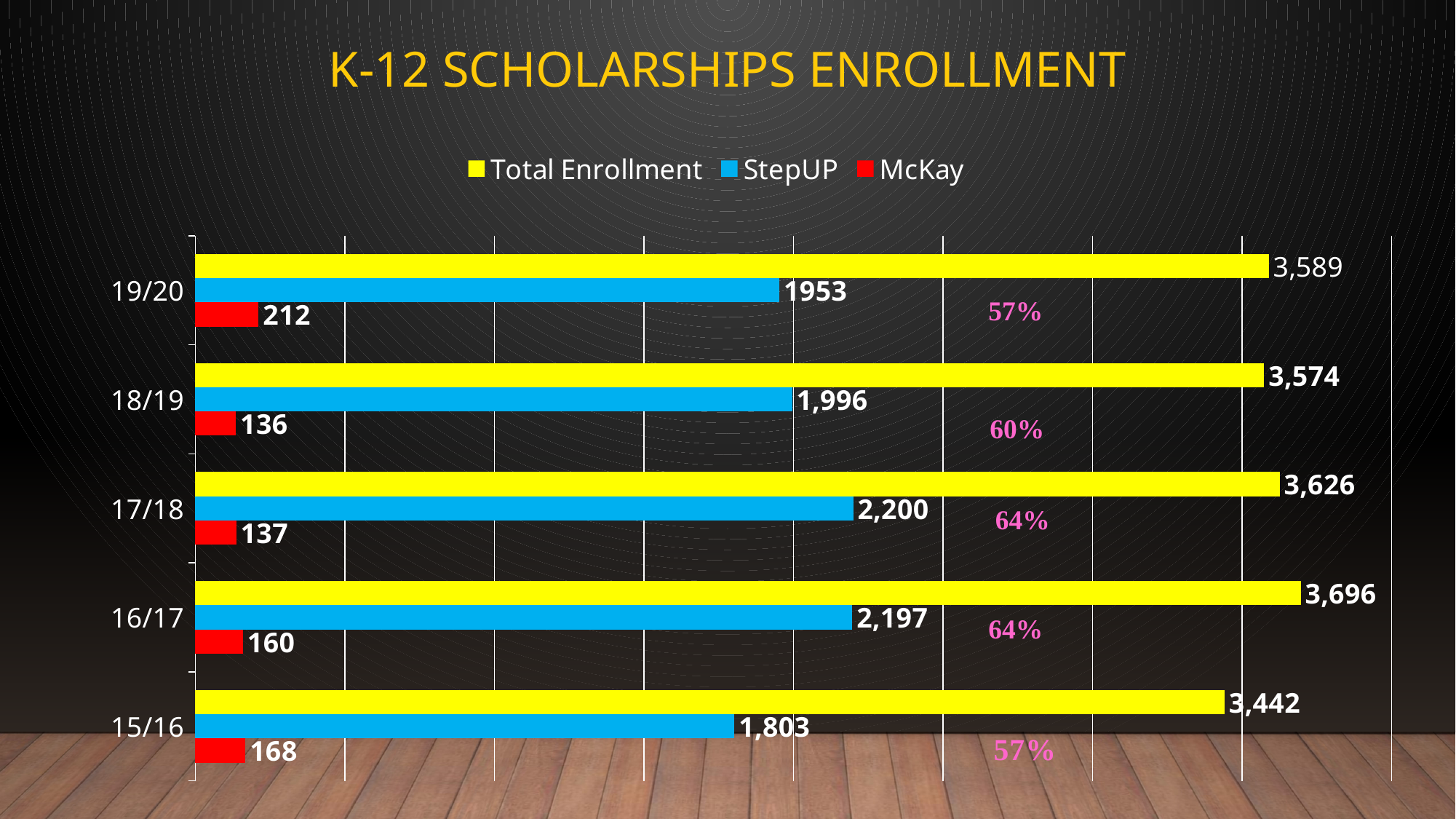
What is the difference between the McKay values for 19/20 and 18/19? 76 Which year has the lowest StepUP value? 15/16 Which year has the lowest Total Enrollment? 15/16 What is the StepUP value for 17/18? 2,200 Is the Total Enrollment for 17/18 larger or smaller than for 18/19? larger Which year has the highest Total Enrollment? 16/17 What is the Total Enrollment value for 19/20? 3,589 Which year has the highest McKay value? 19/20 How many years are shown on the chart? 5 What kind of chart is shown on the slide? bar chart What is the McKay value for 15/16? 168 How many series does the legend list? 3